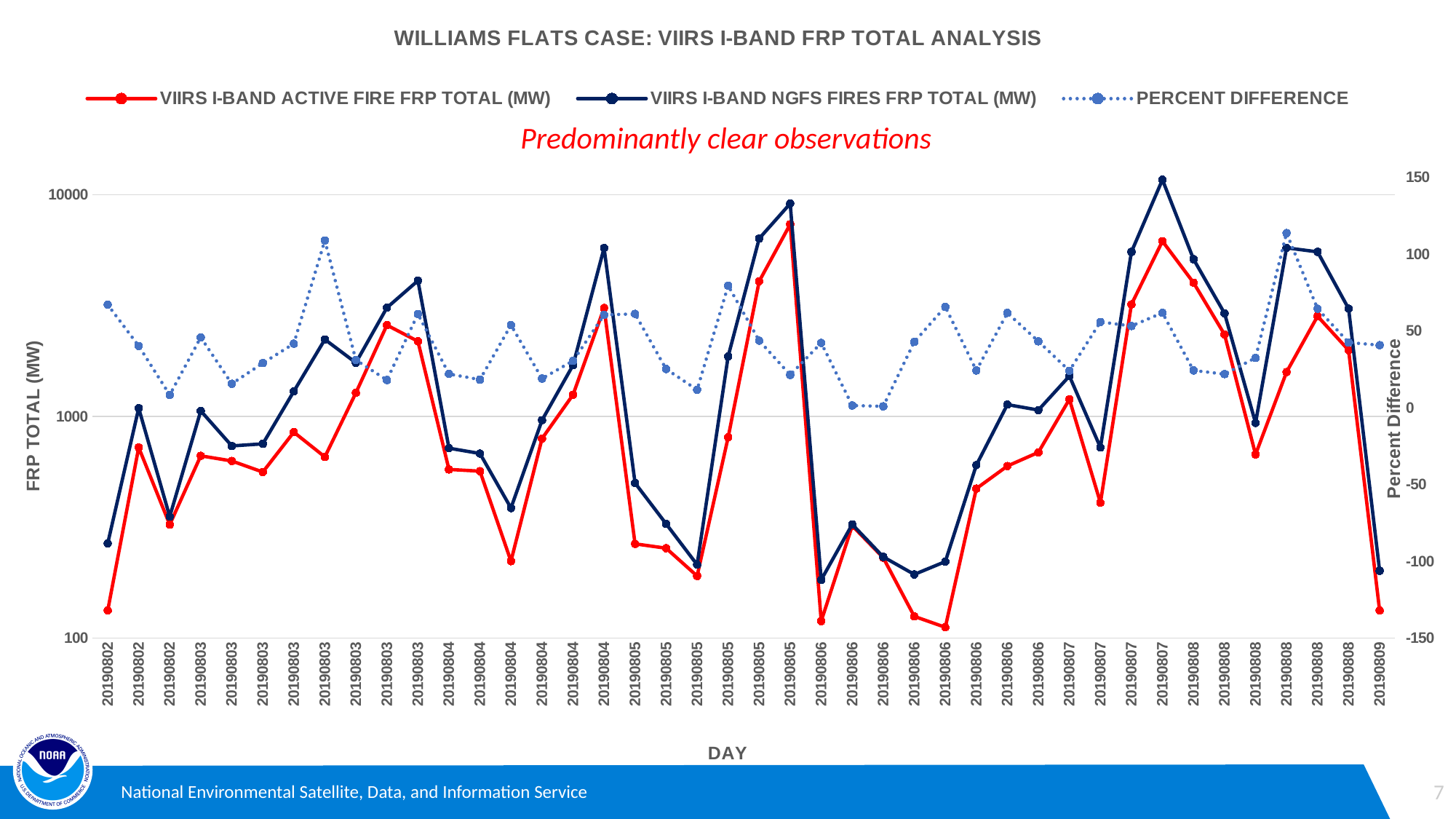
Is the value of the VIIRS I-BAND ACTIVE FIRE FRP TOTAL (MW) series at the first 20190802 point greater or less than 1000? less Is the highest value of the VIIRS I-BAND NGFS FIRES FRP TOTAL (MW) series greater or less than 10000? greater Is the value of the VIIRS I-BAND ACTIVE FIRE FRP TOTAL (MW) series at 20190809 greater or less than 1000? less At the first 20190802 point, which series is larger: VIIRS I-BAND ACTIVE FIRE FRP TOTAL (MW) or VIIRS I-BAND NGFS FIRES FRP TOTAL (MW)? VIIRS I-BAND NGFS FIRES FRP TOTAL (MW) On which day does the VIIRS I-BAND NGFS FIRES FRP TOTAL (MW) series reach its highest value? 20190807 Which series is drawn as a dotted line? PERCENT DIFFERENCE What is the title of the chart? WILLIAMS FLATS CASE: VIIRS I-BAND FRP TOTAL ANALYSIS On which day does the VIIRS I-BAND ACTIVE FIRE FRP TOTAL (MW) series reach its highest value? 20190805 What kind of chart is shown on the slide? Line chart Between the last 20190808 point and 20190809, does the VIIRS I-BAND NGFS FIRES FRP TOTAL (MW) series rise or fall? fall How many series does the legend list? 3